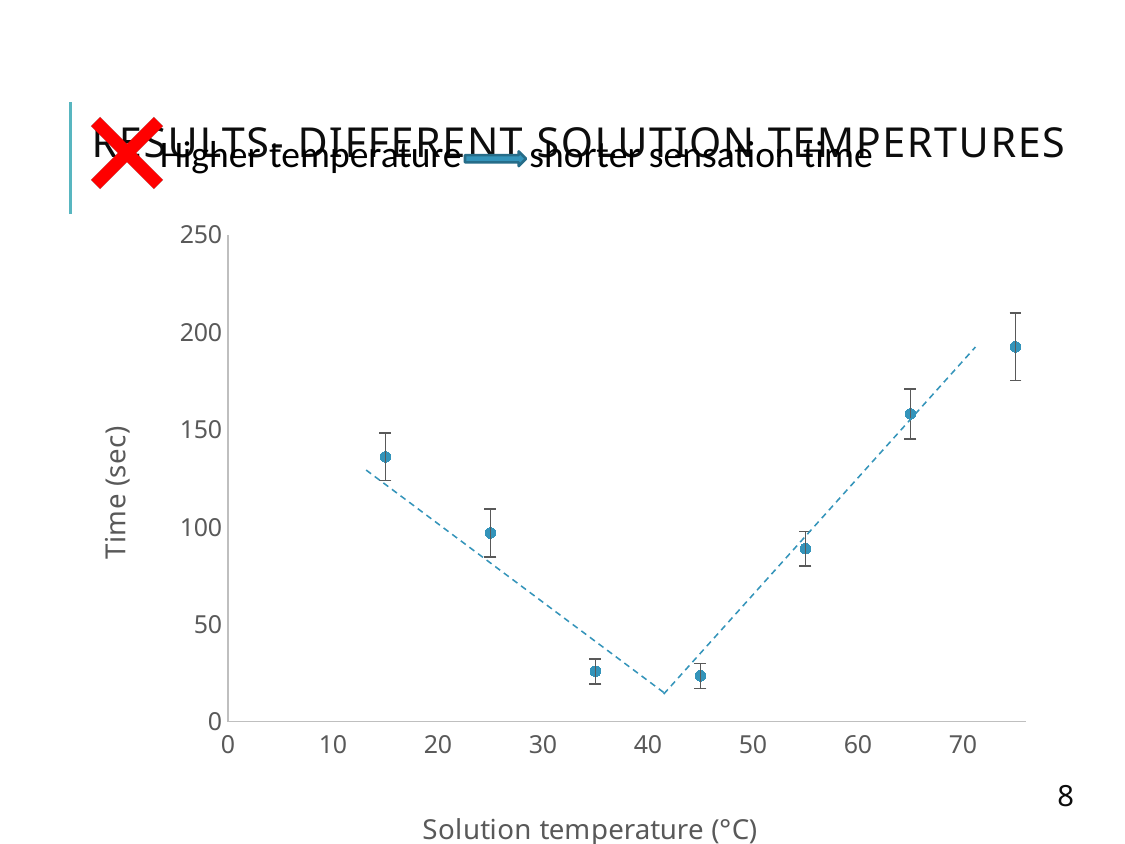
Which has the larger time: the point at 15°C or the point at 25°C? 15°C At which solution temperature is the time highest? 75 What is the label of the y axis? Time (sec) Is the time at a solution temperature of 55°C greater or less than 100 sec? less Is the time at a solution temperature of 35°C greater or less than 50 sec? less Between solution temperatures of 45°C and 75°C, do the time values rise or fall? rise Is the time at a solution temperature of 15°C greater or less than 100 sec? greater Which has the larger time: the point at 55°C or the point at 65°C? 65°C What is the label of the x axis? Solution temperature (°C) What kind of chart is shown on the slide? scatter chart How many data points are plotted on the chart? 7